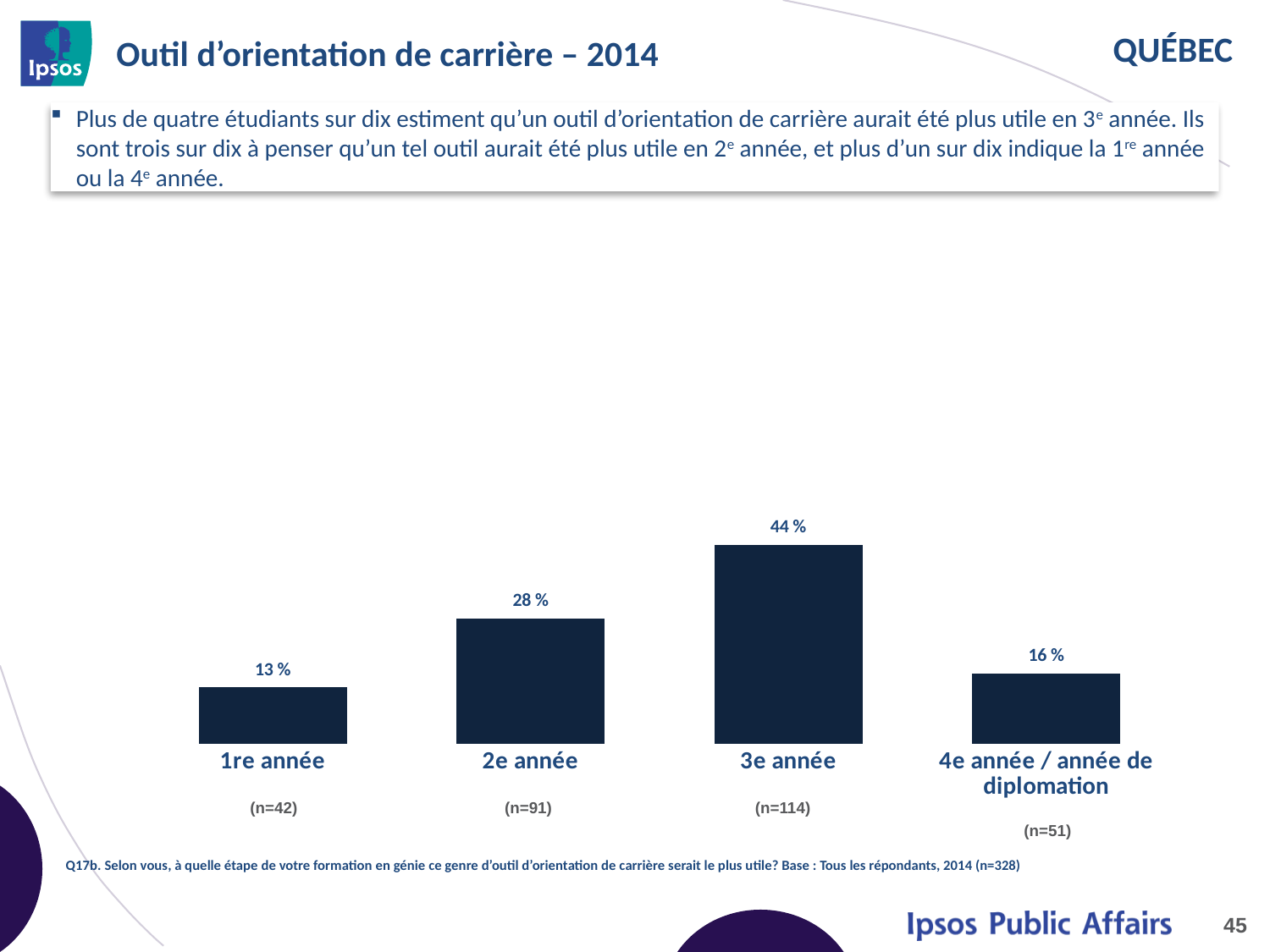
Which is larger, the value for 2e année or the value for 4e année / année de diplomation? 2e année How many categories are shown in the chart? 4 Which category has the lowest value? 1re année What is the value for 4e année / année de diplomation? 16 % What is the difference between the values for 3e année and 2e année? 16 % What is the sample size (n) shown under 3e année? n=114 What is the value for 3e année? 44 % What is the value for 1re année? 13 % What is the value for 2e année? 28 % What kind of chart is shown on the slide? Bar chart Which category has the highest value? 3e année What is the difference between the values for 4e année / année de diplomation and 1re année? 3 %